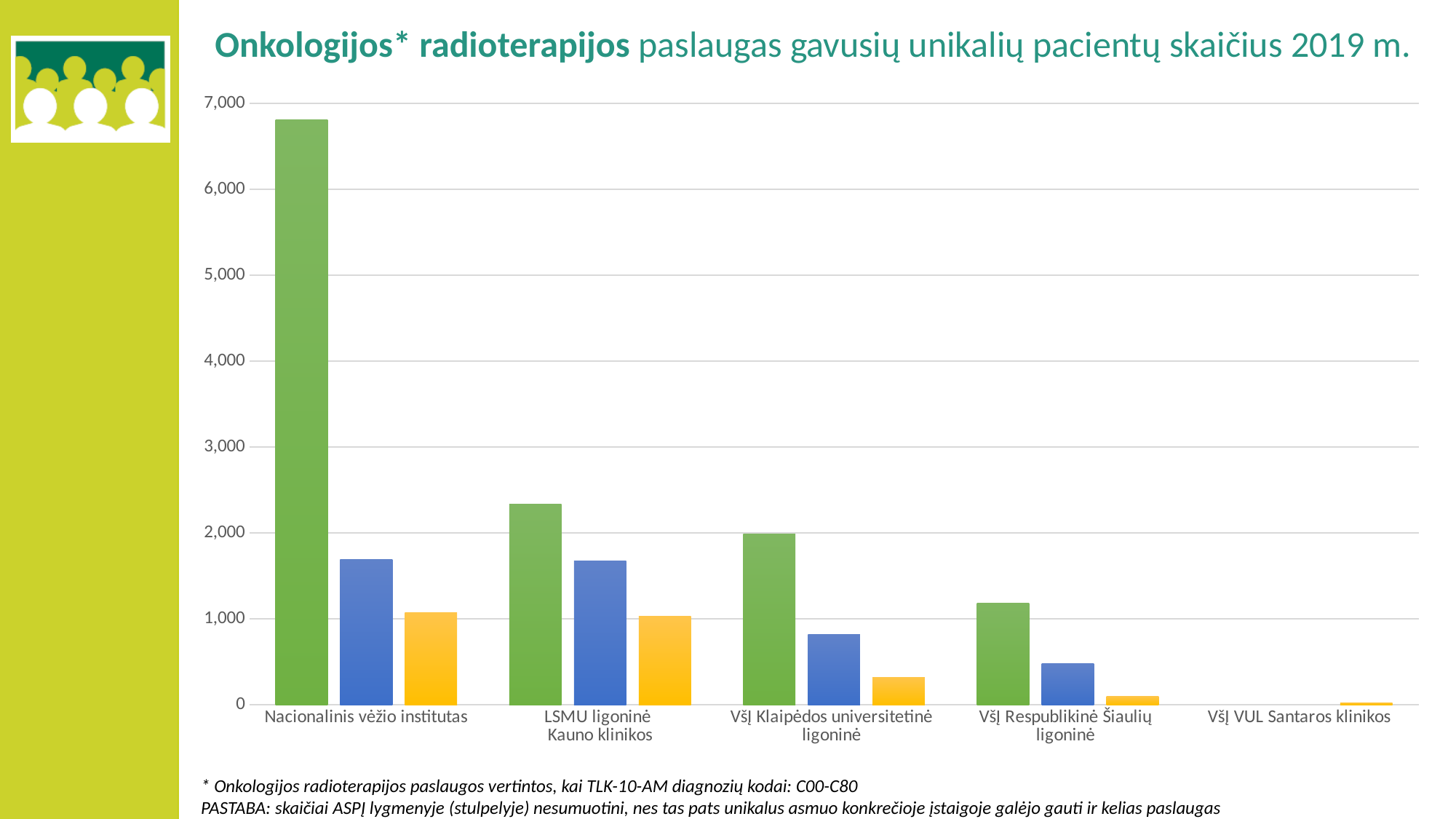
Which is larger: the green bar for LSMU ligoninė Kauno klinikos or the green bar for VšĮ Klaipėdos universitetinė ligoninė? LSMU ligoninė Kauno klinikos Is the green bar for VšĮ Respublikinė Šiaulių ligoninė greater or less than 1,000? greater How many institutions (categories) are shown on the x axis? 5 Which institution has the tallest green bar? Nacionalinis vėžio institutas Is the blue bar for Nacionalinis vėžio institutas greater or less than 2,000? less Is the green bar for LSMU ligoninė Kauno klinikos greater or less than 2,000? greater How many bars are plotted for each institution? 3 for each institution except VšĮ VUL Santaros klinikos, which has only 1 Do the green bars rise or fall from left to right across the institutions? fall What kind of chart is shown on the slide? bar chart Which institution has the lowest bars overall? VšĮ VUL Santaros klinikos